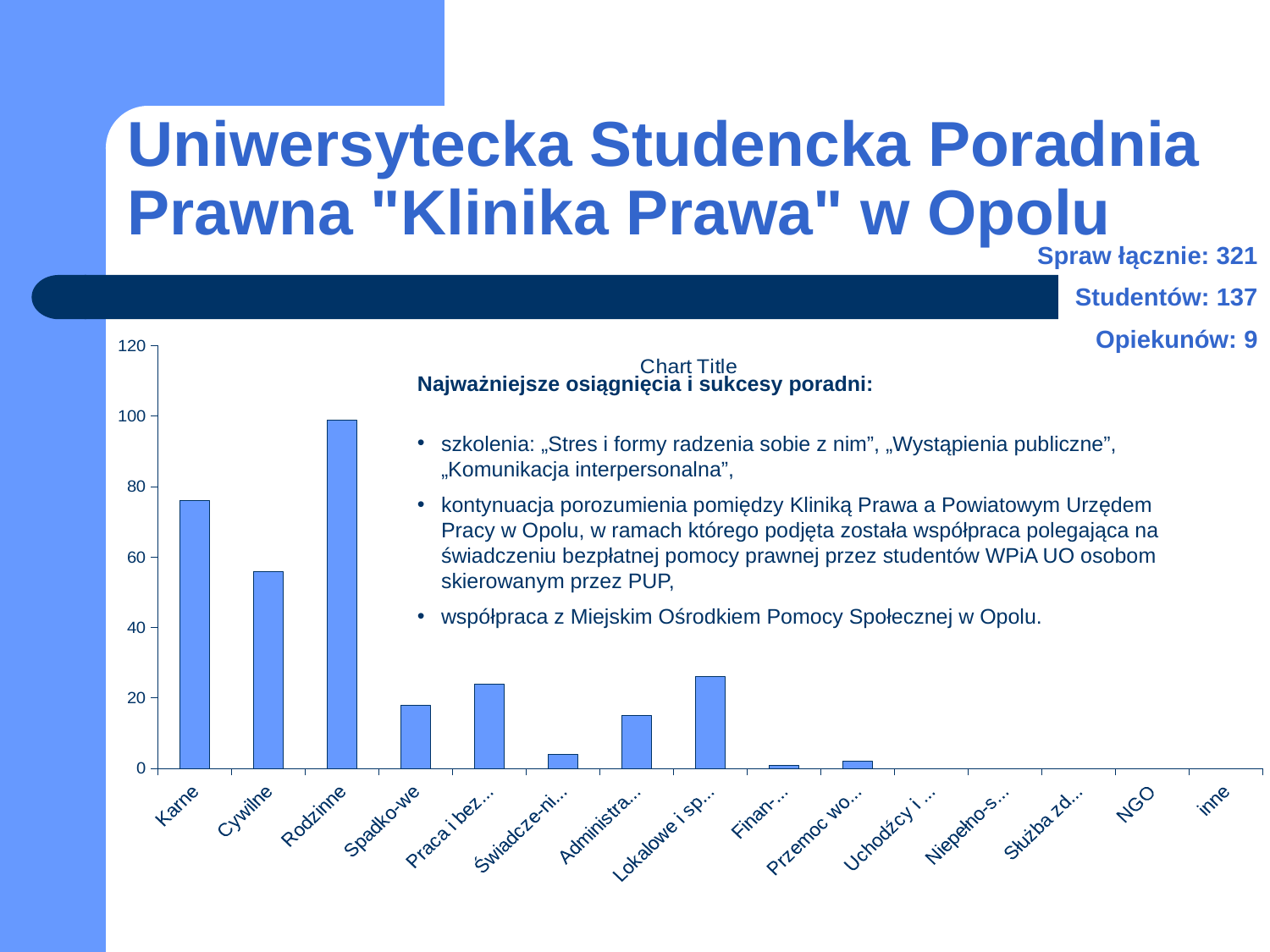
Is the value for Cywilne greater or less than 80? less Which is larger, the value for Lokalowe i sp... or the value for Administra...? Lokalowe i sp... What kind of chart is shown on the slide? bar chart What is the title shown on the chart? Chart Title Which category has the highest bar in the chart? Rodzinne Is the value for Lokalowe i sp... greater or less than 20? greater Is the value for Rodzinne greater or less than 80? greater How many categories are shown on the x axis of the chart? 15 Which is larger, the value for Karne or the value for Cywilne? Karne